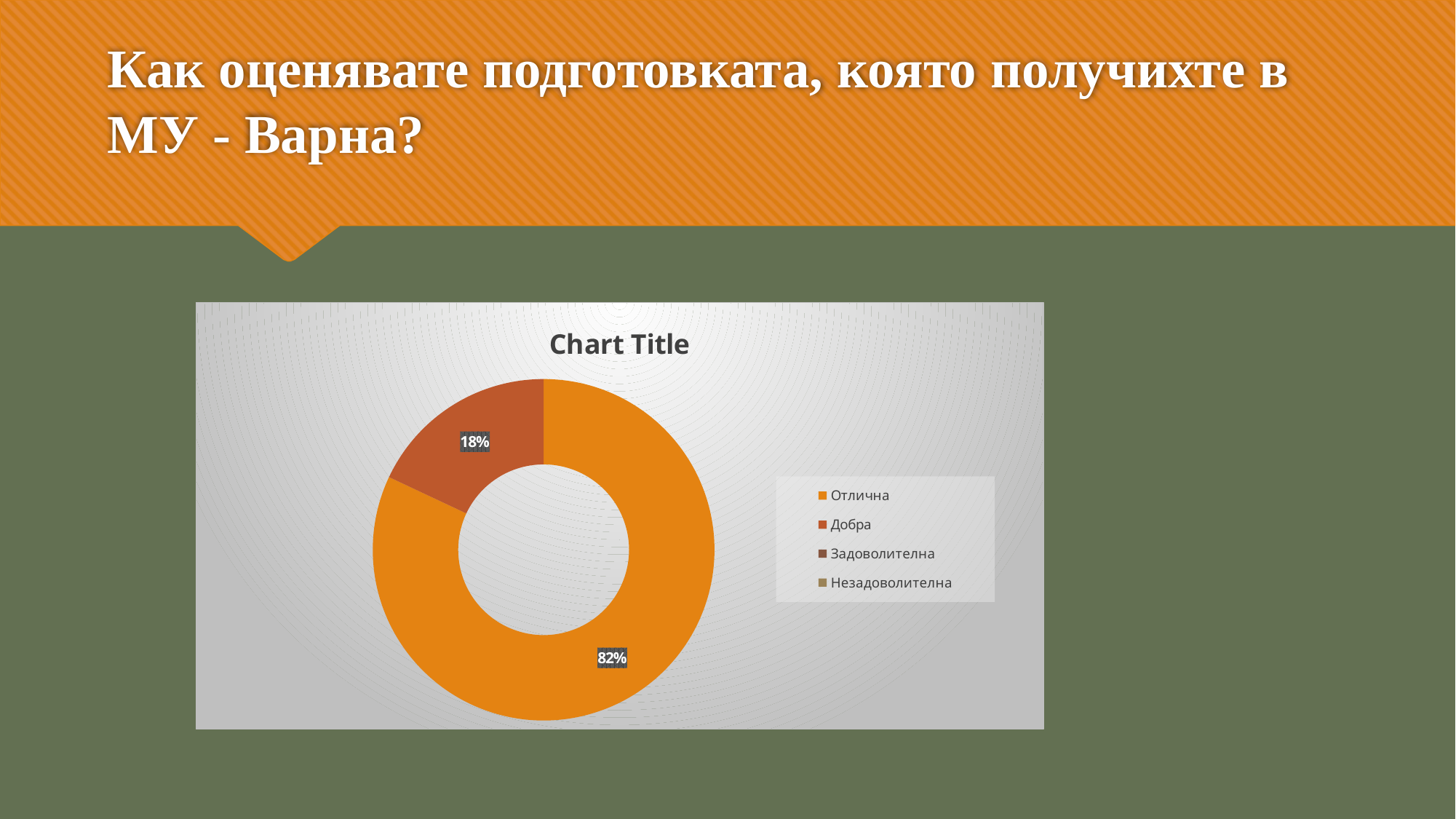
What type of chart is shown on the slide? Doughnut chart Which of the two labelled slices is larger, Отлична or Добра? Отлична Which legend entry is listed last in the chart legend? Незадоволителна What is the combined share of the Отлична and Добра slices? 100% What share of the doughnut chart does the Отлична slice represent? 82% What is the title printed above the chart? Chart Title How many entries does the chart legend list? 4 Which category has the largest slice in the chart? Отлична What is the difference in percentage points between the Отлична slice and the Добра slice? 64 How many slices with data labels are visible in the chart? 2 What share of the doughnut chart does the Добра slice represent? 18%